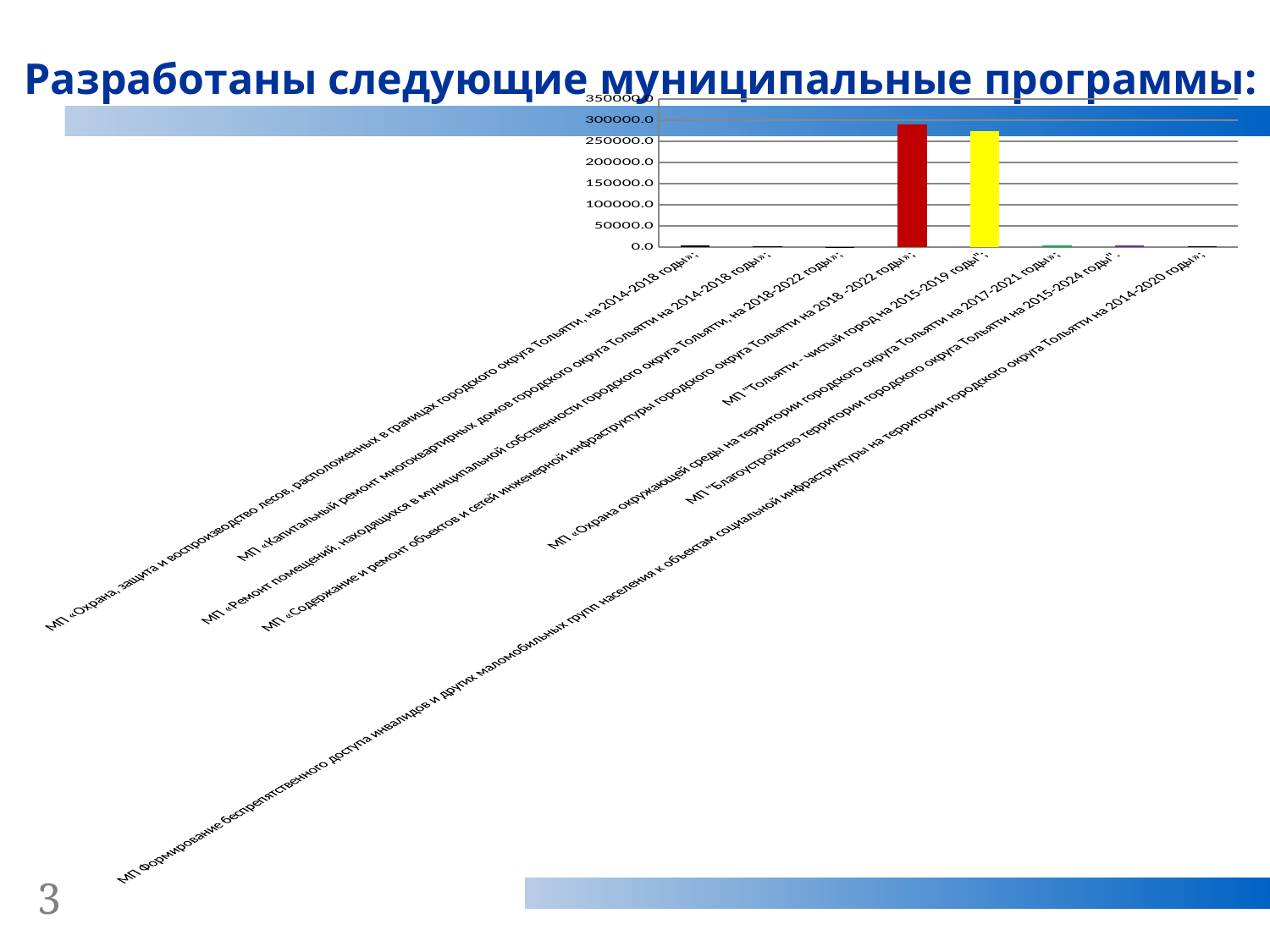
Is the value for МП "Тольятти - чистый город на 2015-2019 годы" greater or less than 250000.0? greater Is the value for МП «Охрана, защита и воспроизводство лесов, расположенных в границах городского округа Тольятти, на 2014-2018 годы» greater or less than 50000.0? less Is the value for МП "Тольятти - чистый город на 2015-2019 годы" greater or less than 300000.0? less What kind of chart is shown on the slide? bar chart Which municipal programme has the highest bar in the chart? МП «Содержание и ремонт объектов и сетей инженерной инфраструктуры городского округа Тольятти на 2018-2022 годы» Which is larger: the value for МП «Содержание и ремонт объектов и сетей инженерной инфраструктуры городского округа Тольятти на 2018-2022 годы» or the value for МП "Тольятти - чистый город на 2015-2019 годы"? МП «Содержание и ремонт объектов и сетей инженерной инфраструктуры городского округа Тольятти на 2018-2022 годы» What is the highest value shown on the chart's vertical axis? 350000.0 How many municipal programmes (categories) are plotted on the x axis of the chart? 8 What colour is the bar for МП "Тольятти - чистый город на 2015-2019 годы"? yellow